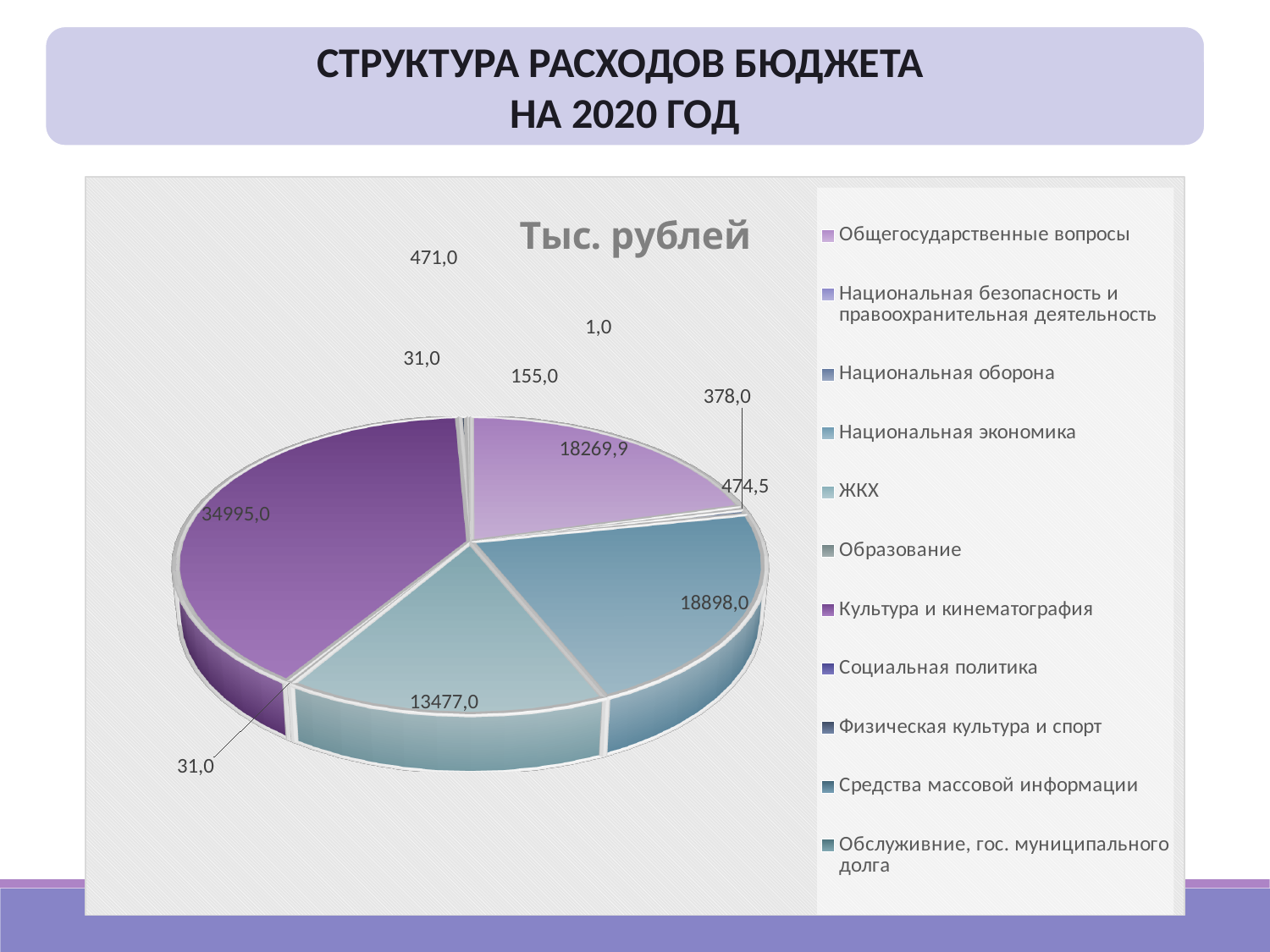
What is the value for ЖКХ? 13477,0 What is the value for Общегосударственные вопросы? 18269,9 What is the value for Национальная экономика? 18898,0 What is the difference between the value for Национальная экономика and the value for ЖКХ? 5421,0 Which is larger, the value for Национальная экономика or the value for Общегосударственные вопросы? Национальная экономика How many categories does the chart legend list? 11 What is the smallest value labelled on the pie chart? 1,0 What is the value of the largest slice in the pie chart? 34995,0 What kind of chart is shown on the slide? pie chart What is the difference between the value for Культура и кинематография and the value for Национальная экономика? 16097,0 What is the title of the chart? Тыс. рублей Which category has the largest slice in the pie chart? Культура и кинематография